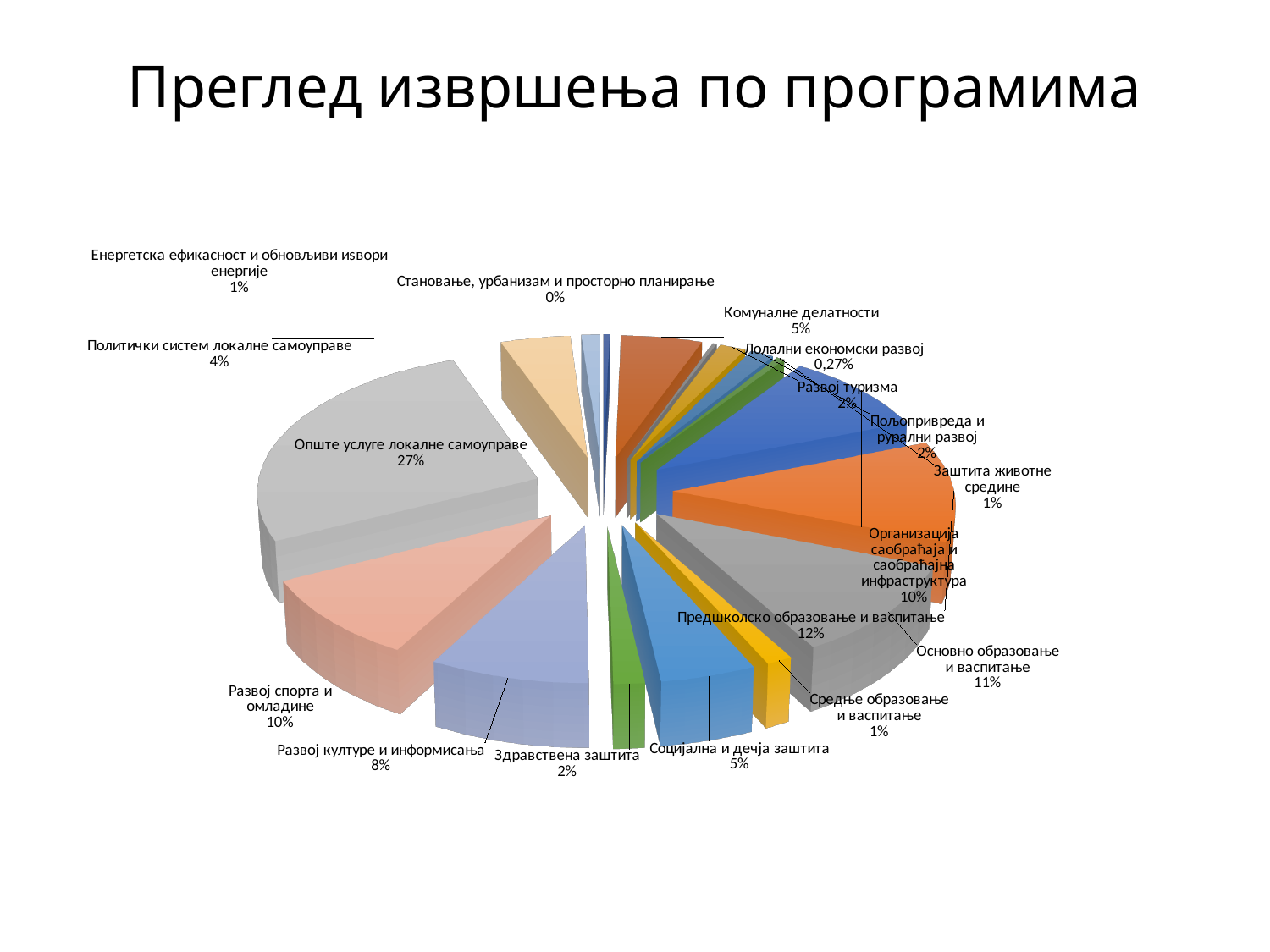
What is the value shown for Развој културе и информисања? 8% What share of the pie does Опште услуге локалне самоуправе have? 27% What kind of chart is shown on the slide? pie chart How many categories (slices) does the pie chart have? 17 What is the difference in percentage points between Опште услуге локалне самоуправе and Предшколско образовање и васпитање? 15 Which is larger, Основно образовање и васпитање or Организација саобраћаја и саобраћајна инфраструктура? Основно образовање и васпитање What is the value shown for Предшколско образовање и васпитање? 12% Which category has the largest share of the pie? Опште услуге локалне самоуправе What is the title of the chart on the slide? Преглед извршења по програмима What is the value shown for Локални економски развој? 0,27% What is the value shown for Социјална и дечја заштита? 5%